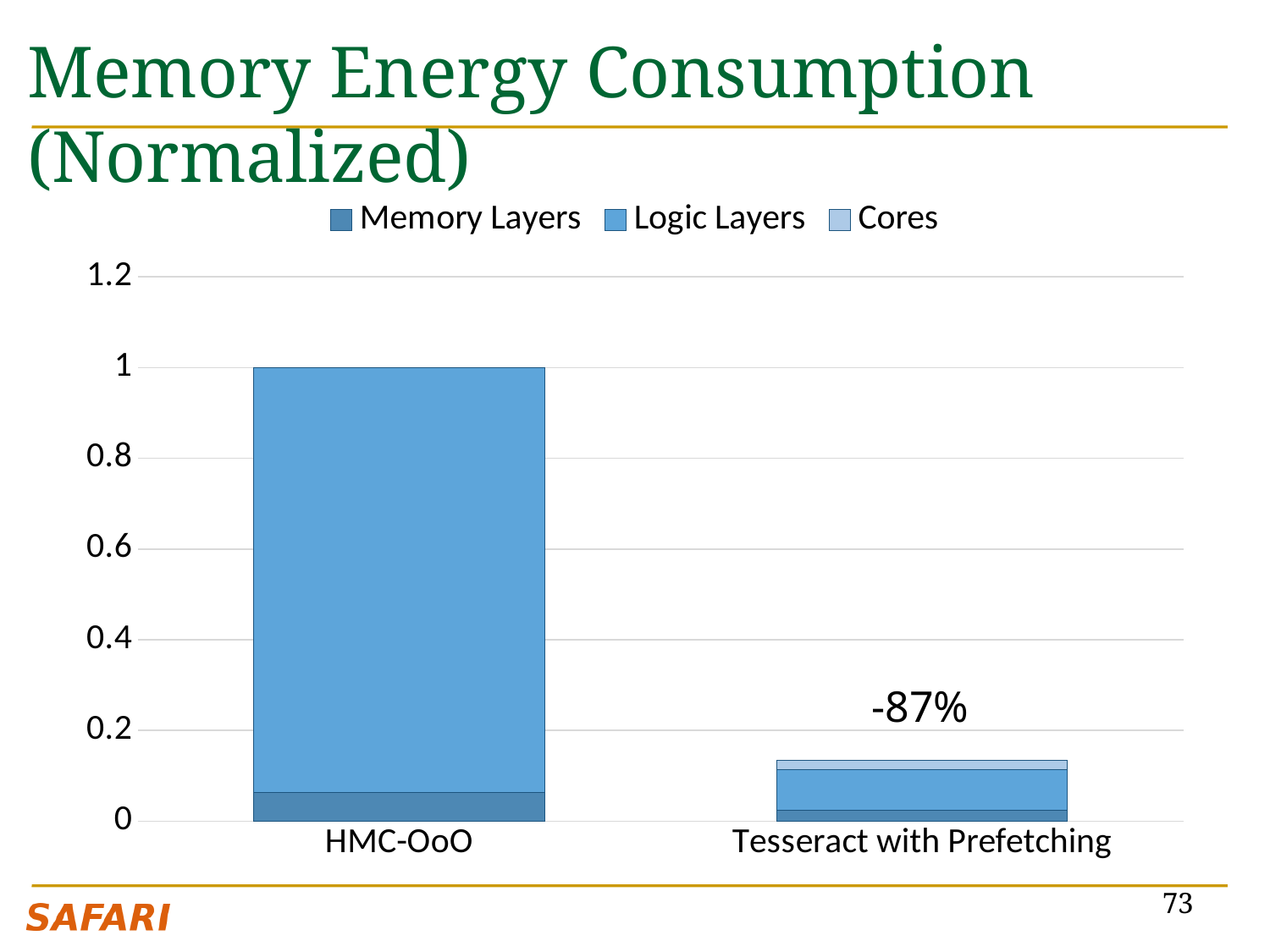
What kind of chart is shown on the slide? bar chart Is the total value for Tesseract with Prefetching greater or less than 0.2? less How many categories are shown on the x axis of the chart? 2 What is the total normalized memory energy consumption for HMC-OoO? 1 How many series does the chart's legend list? 3 Which has a larger total bar, HMC-OoO or Tesseract with Prefetching? HMC-OoO Which category has the lowest total normalized memory energy consumption? Tesseract with Prefetching What percentage change is labeled above the Tesseract with Prefetching bar? -87% Which category has the highest total normalized memory energy consumption? HMC-OoO What is the title of the slide containing the chart? Memory Energy Consumption (Normalized) Is the total value for HMC-OoO greater or less than 0.8? greater What are the three series listed in the chart's legend? Memory Layers, Logic Layers, Cores